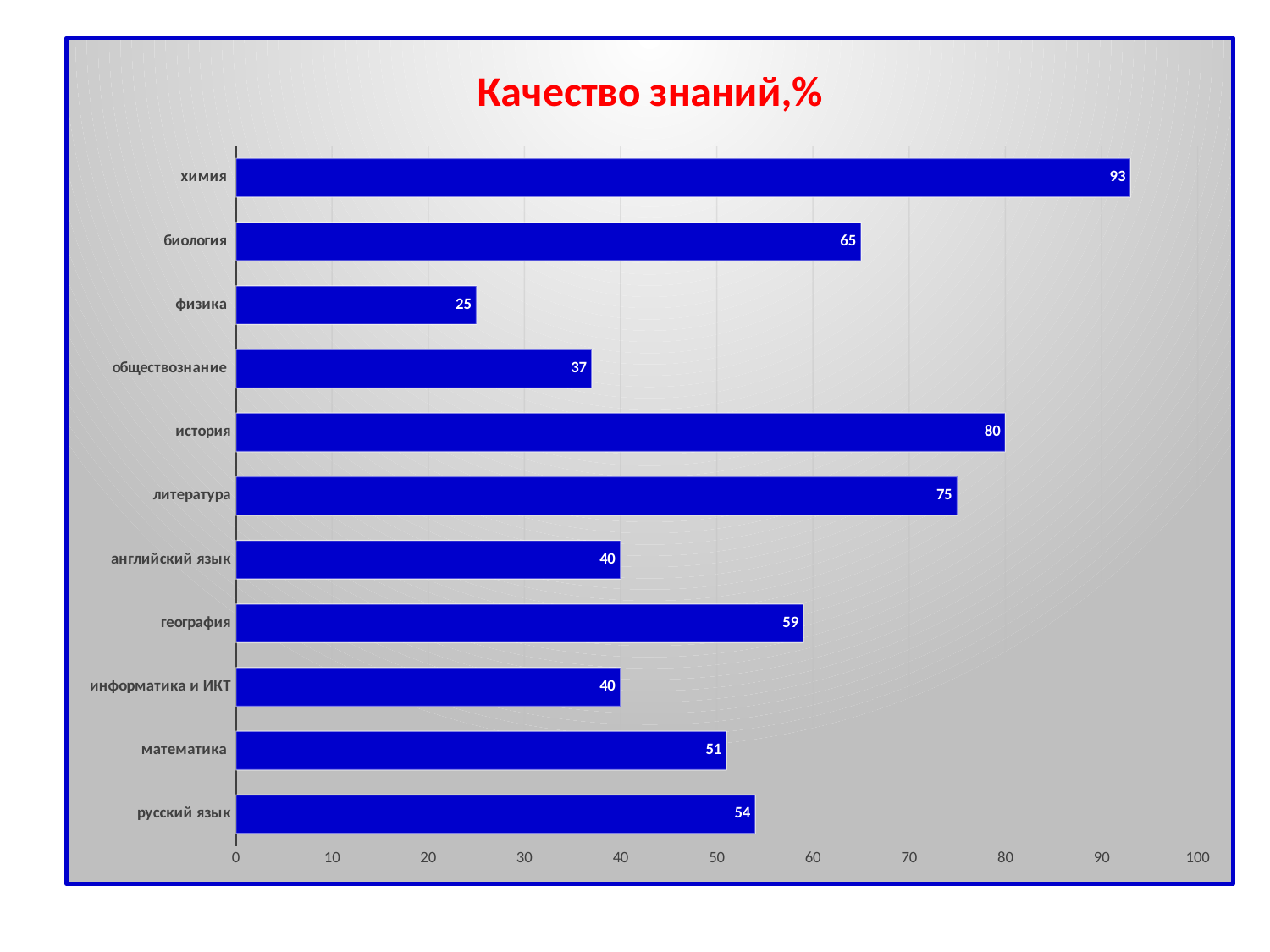
What is the value for химия? 93 How many categories are shown in the chart? 11 What is the difference between the values for химия and физика? 68 What is the title of the chart? Качество знаний,% What is the value for обществознание? 37 What kind of chart is shown on the slide? bar chart What is the value for география? 59 Which category has the highest value? химия Is the value for биология greater or less than 60? greater Which is larger, the value for математика or the value for русский язык? русский язык Which category has the lowest value? физика What is the difference between the values for история and литература? 5